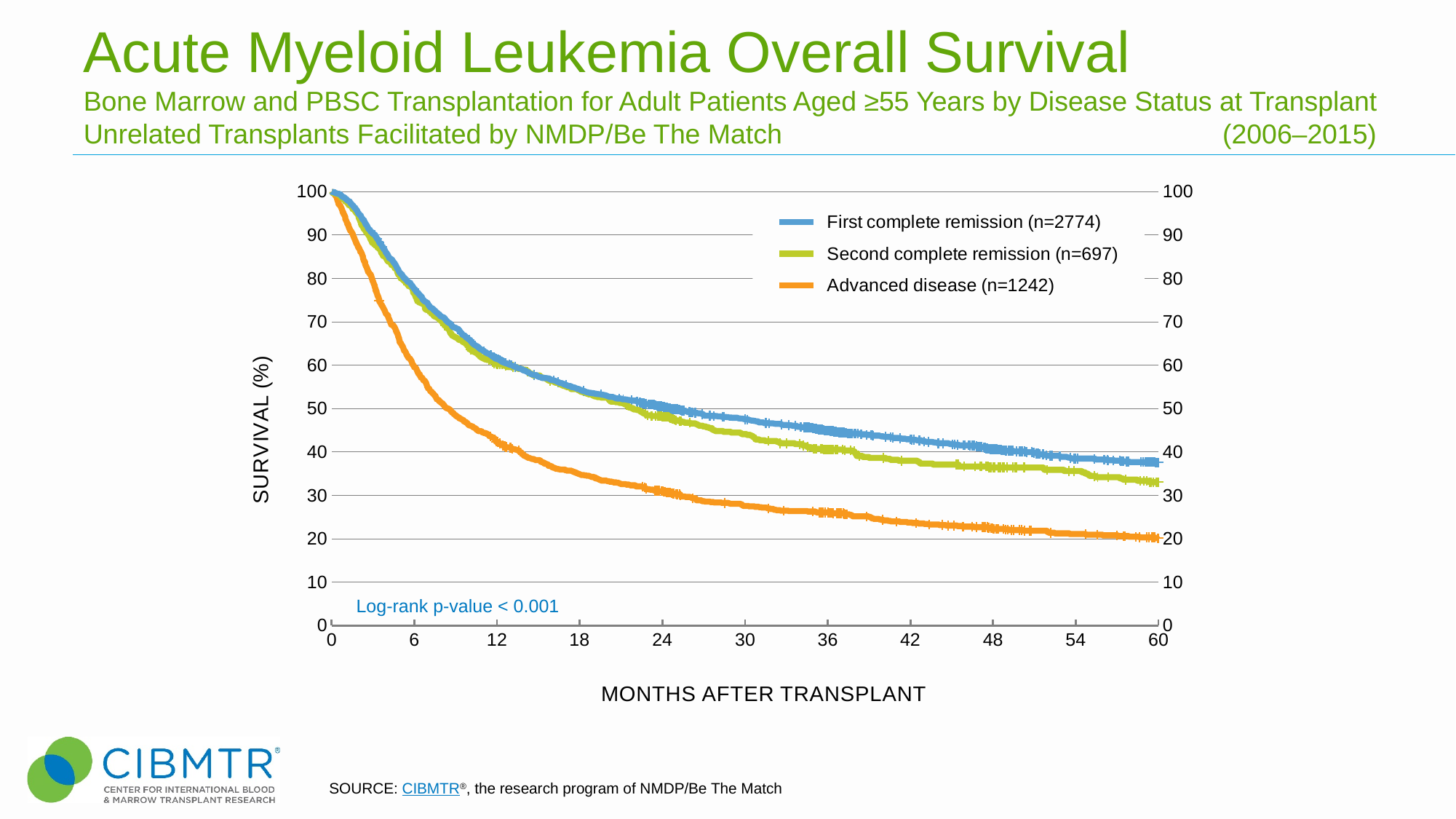
Do the survival curves rise or fall as months after transplant increase? fall What kind of chart is shown on the slide? line chart Is the survival for first complete remission at 12 months greater or less than 50? greater How many patients are in the first complete remission group according to the legend? n=2774 Is the survival for second complete remission at 60 months greater or less than 40? less Which group has the highest survival at 60 months after transplant? First complete remission At 36 months, which is higher: survival for second complete remission or for advanced disease? Second complete remission Is the survival for advanced disease at 12 months greater or less than 60? less What is the survival value for all three groups at 0 months after transplant? 100 Which group has the lowest survival at 60 months after transplant? Advanced disease How many series does the legend list? 3